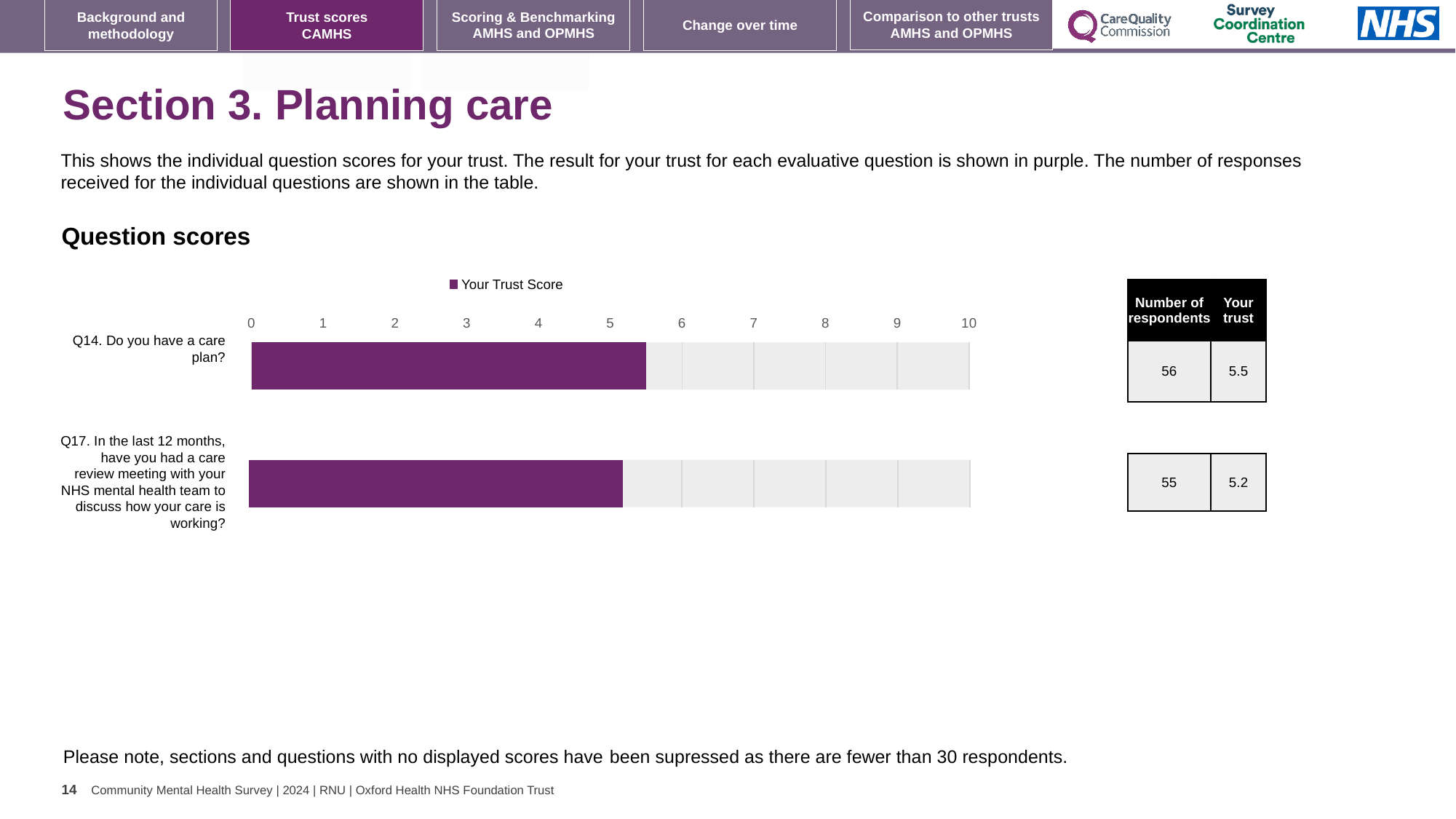
What is the difference between the trust scores for Q14 and Q17? 0.3 What type of chart is shown on the slide? Bar chart What is the name of the series shown in the legend? Your Trust Score How many series does the legend list? 1 Is the trust score for Q17 greater or less than 6? less How many questions are plotted on the chart? 2 Which question has the higher trust score, Q14 or Q17? Q14 How many respondents answered Q14 according to the table? 56 What is the trust score for Q14 'Do you have a care plan?'? 5.5 Which question has the lowest trust score on the chart? Q17 What is the trust score for Q17 about having a care review meeting in the last 12 months? 5.2 Is the trust score for Q14 greater or less than 5? greater